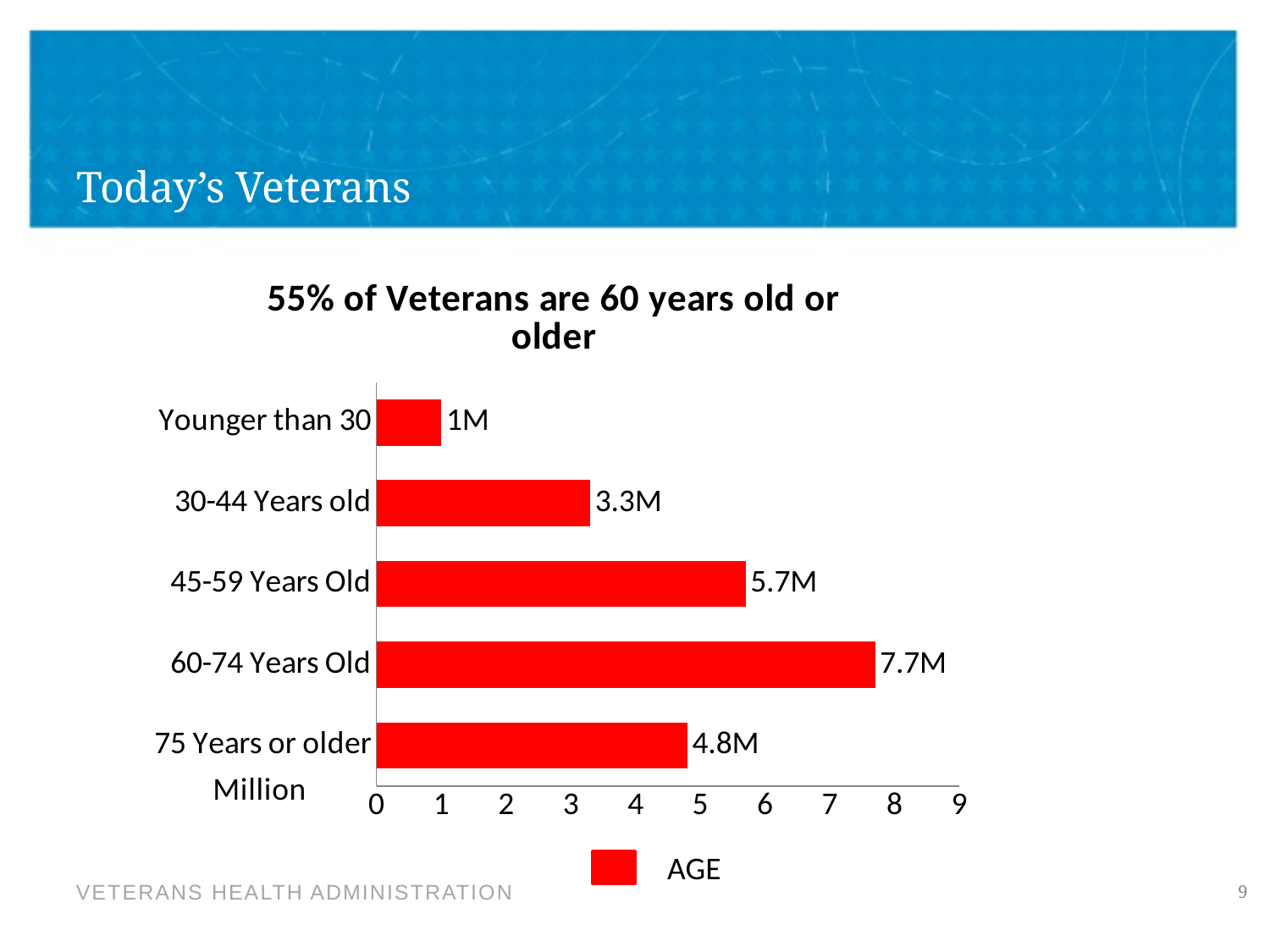
What kind of chart is shown on the slide? bar chart Is the value for 45-59 Years Old greater or less than 5? greater Which is larger, the value for 30-44 Years old or the value for 75 Years or older? 75 Years or older What is the value for 75 Years or older? 4.8M What is the value for Younger than 30? 1M How many age categories are shown in the chart? 5 Which age group has the highest value? 60-74 Years Old What is the value for 60-74 Years Old? 7.7M What is the difference between the values for 60-74 Years Old and 45-59 Years Old? 2M What is the title of the chart? 55% of Veterans are 60 years old or older Which age group has the lowest value? Younger than 30 How many series does the legend list? 1